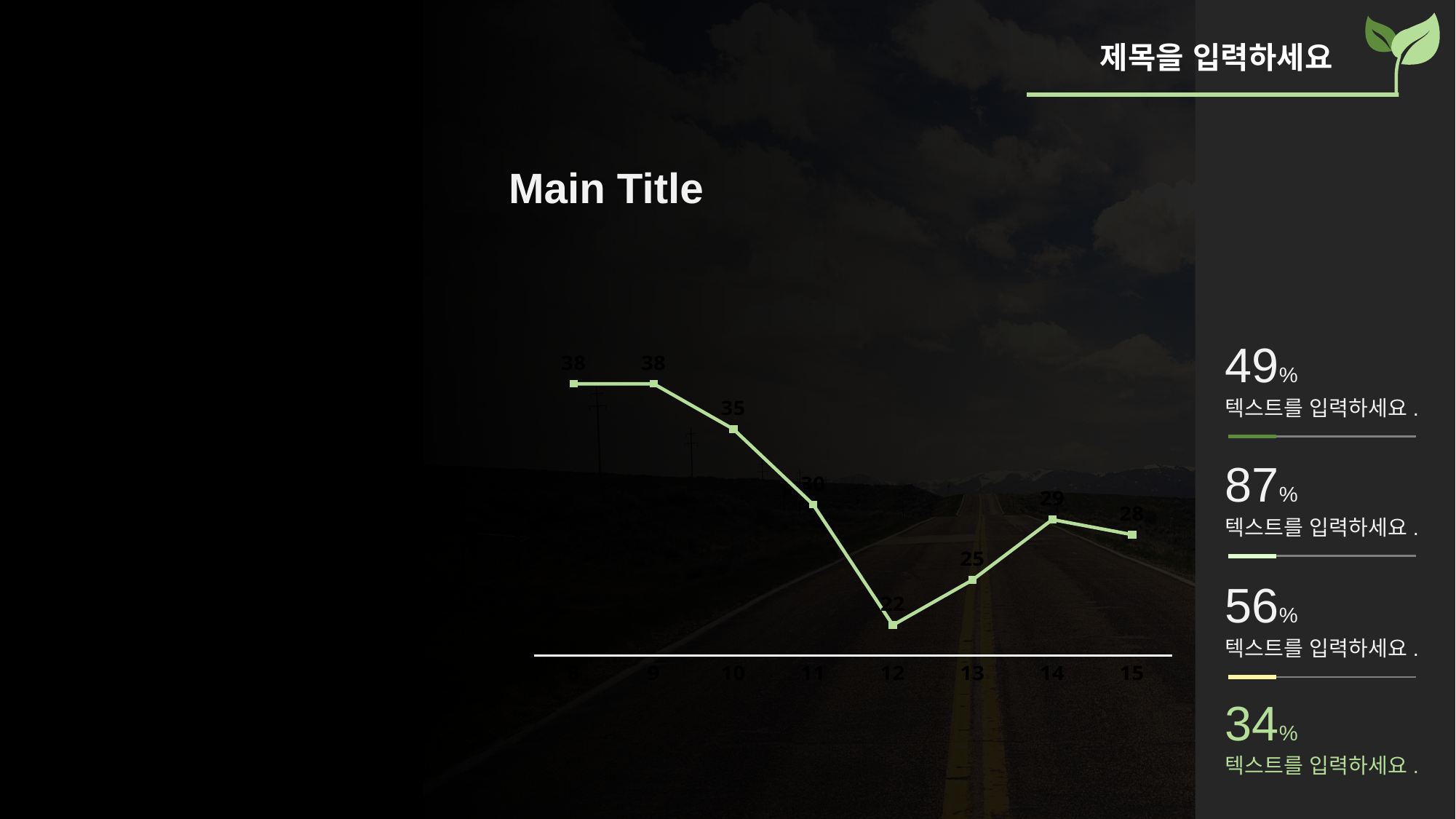
Does the line chart rise or fall from x = 8 to x = 12? fall At which x value is the line chart lowest? 12 What is the value at x = 14 on the line chart? 29 What is the difference between the values at x = 8 and x = 12? 16 What is the value at x = 12 on the line chart? 22 How many data points are plotted on the line chart? 8 What is the value at x = 15 on the line chart? 28 Which is larger, the value at x = 11 or the value at x = 13? x = 11 What is the value at x = 10 on the line chart? 35 What is the difference between the values at x = 13 and x = 14? 4 What kind of chart is shown on the slide? line chart What is the highest value plotted on the line chart? 38